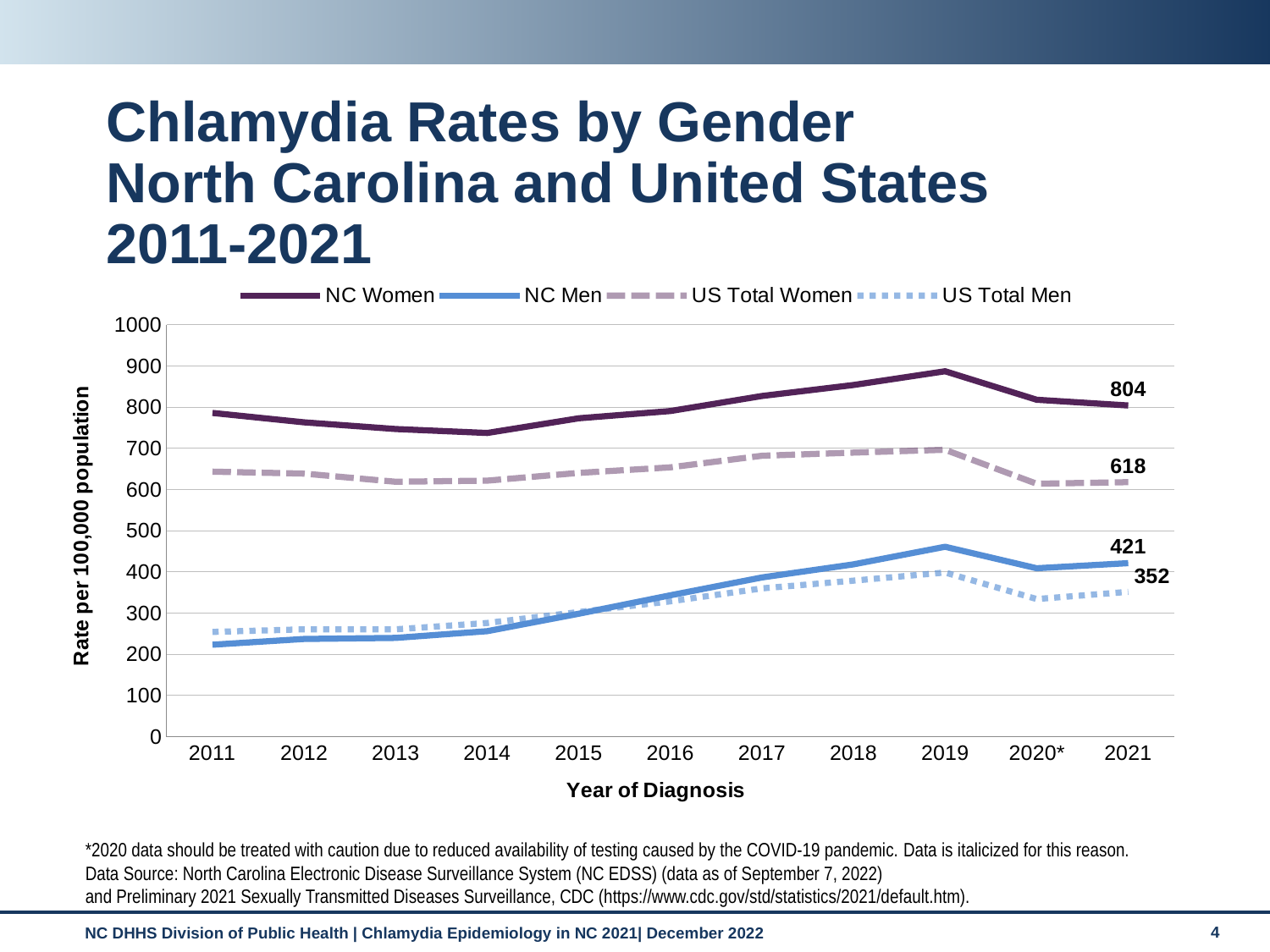
What is the US Total Women rate in 2021? 618 How many series does the legend list? 4 What kind of chart is shown on the slide? line chart What is the difference between the NC Women and US Total Women rates in 2021? 186 Is the NC Men rate in 2011 greater or less than 300? less In 2021, which is larger: the NC Men rate or the US Total Men rate? NC Men Which series has the highest rate in 2021? NC Women How many years are shown on the x axis? 11 What is the US Total Men rate in 2021? 352 In which year does the NC Women line reach its highest point? 2019 What is the difference between the NC Men and US Total Men rates in 2021? 69 What is the NC Women chlamydia rate in 2021? 804